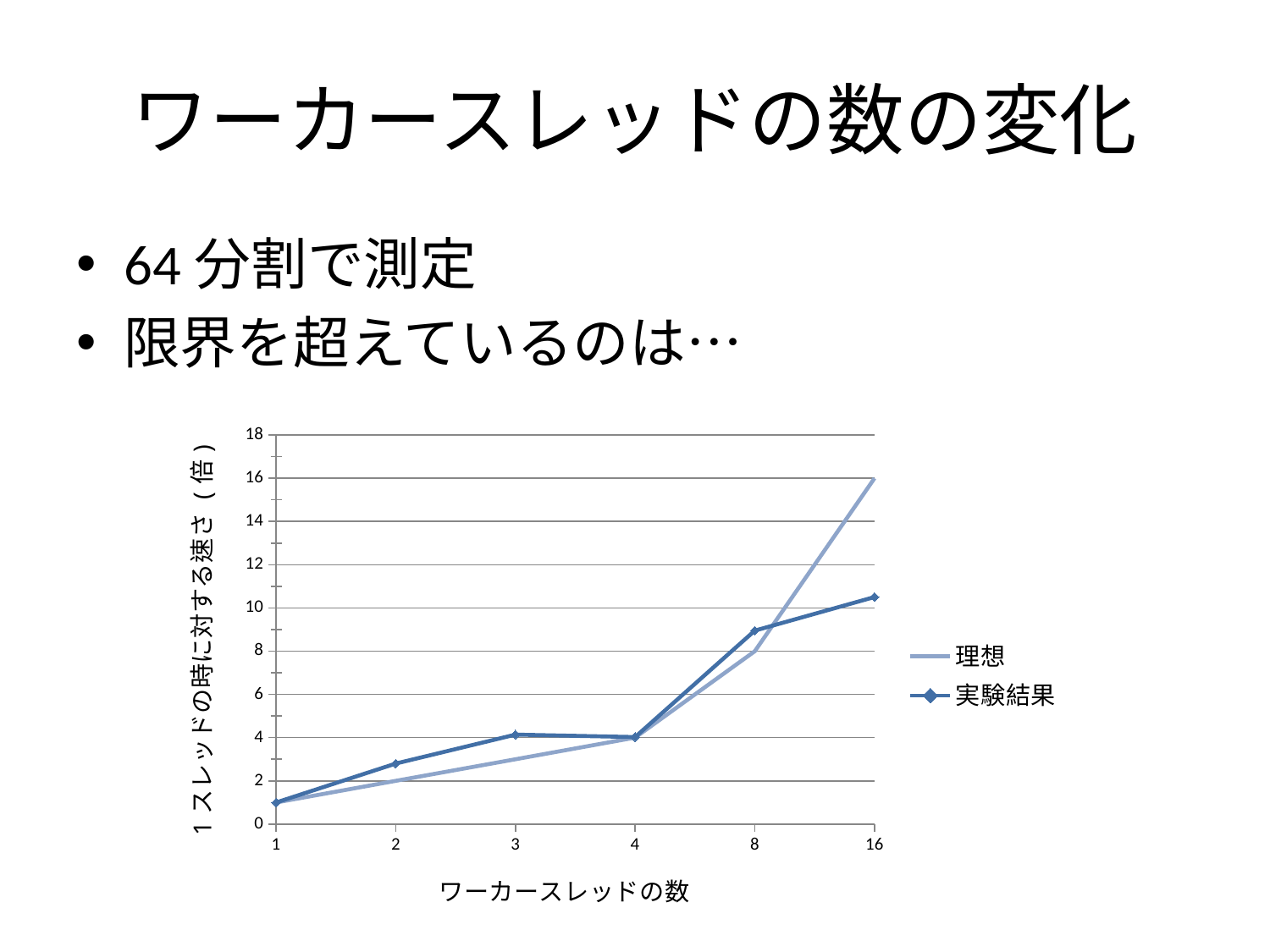
What is the title of the x axis? ワーカースレッドの数 At 2 worker threads, which series has the larger value, 理想 or 実験結果? 実験結果 How many series does the legend list? 2 What kind of chart is shown on the slide? line chart Is the value of 実験結果 at 8 worker threads greater or less than 8? greater What is the value of the 理想 series at 4 worker threads? 4 Is the value of 実験結果 at 16 worker threads greater or less than 12? less At 16 worker threads, which series has the larger value, 理想 or 実験結果? 理想 What is the value of the 理想 series at 16 worker threads? 16 What is the value of the 理想 series at 8 worker threads? 8 How many worker-thread counts are plotted along the x axis? 6 At which number of worker threads does the 実験結果 series reach its highest value? 16